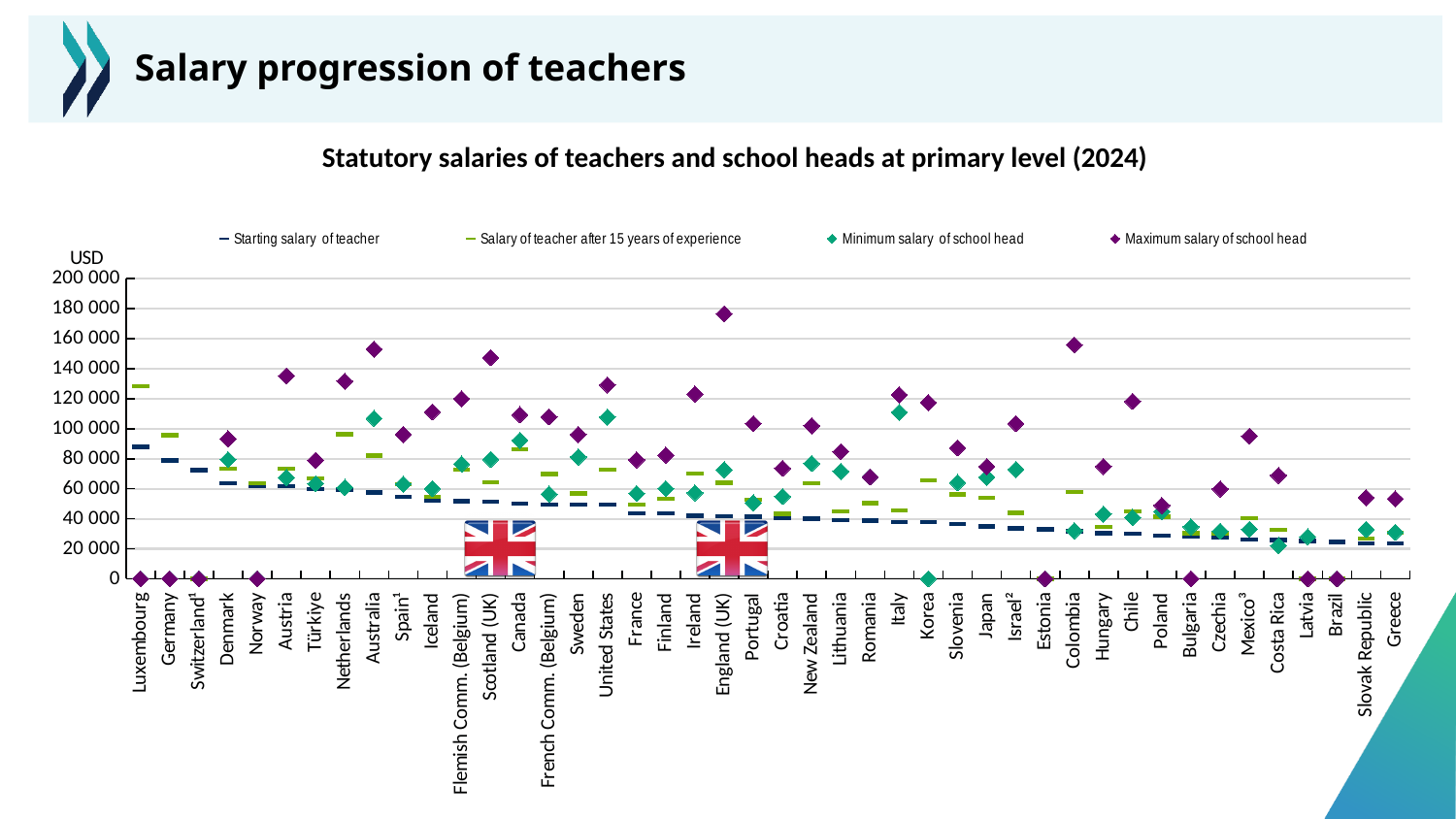
Which country has the highest maximum salary of school head? England (UK) Does the starting salary of teacher generally rise or fall moving from left to right along the x axis? fall Which country has the highest starting salary of teacher? Luxembourg What unit is shown on the vertical axis of the chart? USD Is the maximum salary of school head for Greece greater or less than 60 000? less How many series does the chart legend list? 4 How many countries or regions are shown along the x axis of the chart? 44 Which is larger, the maximum salary of school head for England (UK) or for Ireland? England (UK) What is the title of the chart? Statutory salaries of teachers and school heads at primary level (2024) Is the maximum salary of school head for England (UK) greater or less than 160 000? greater Is the maximum salary of school head for Australia greater or less than 140 000? greater